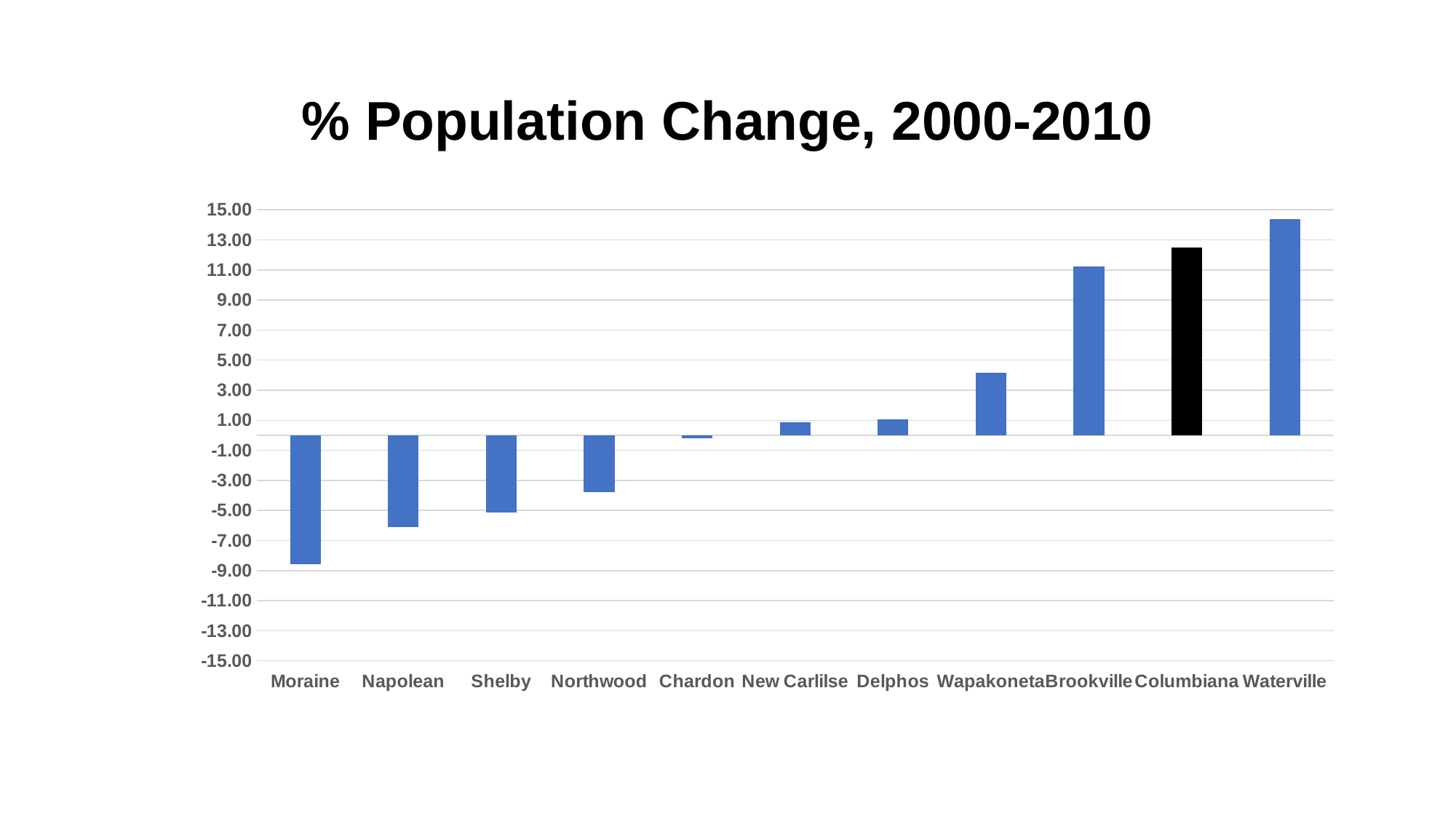
Which city has the lowest % population change? Moraine Do the values generally rise or fall moving from left to right along the x axis? rise What type of chart is shown on the slide? bar chart Is the value for Wapakoneta greater or less than 3.00? greater Which city has the highest % population change? Waterville What is the title of the chart? % Population Change, 2000-2010 How many cities are shown on the x axis of the chart? 11 Which has the larger % population change, Brookville or Wapakoneta? Brookville Which city's bar is coloured black rather than blue? Columbiana Is the value for Northwood greater or less than -3.00? less Is the value for Moraine greater or less than -7.00? less